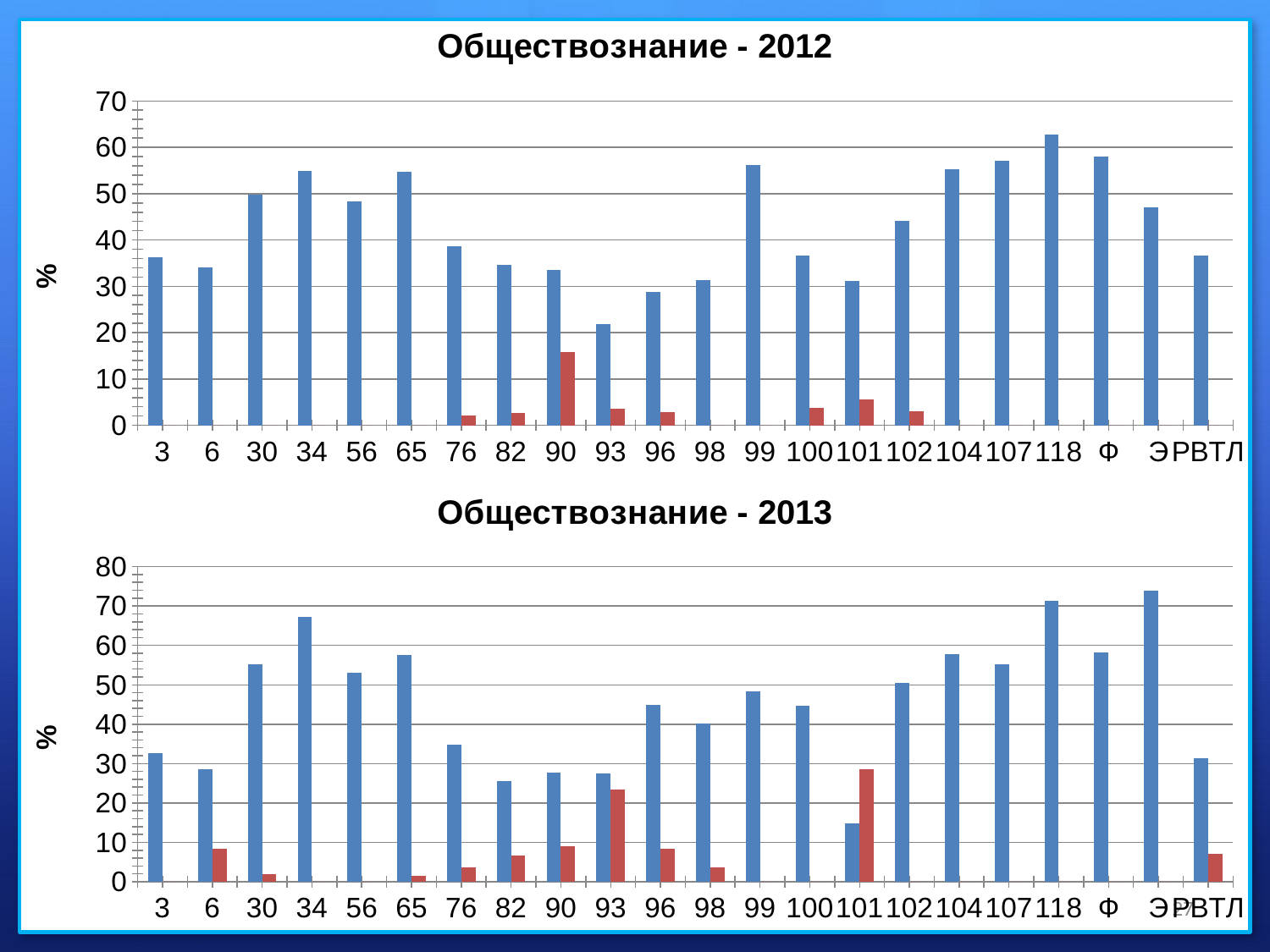
What type of chart is shown in the top chart titled "Обществознание - 2012"? bar chart In the "Обществознание - 2012" chart, which blue bar is taller: category 34 or category 3? 34 In the "Обществознание - 2012" chart, which category has the shortest blue bar? 93 In the "Обществознание - 2013" chart, which category has the shortest blue bar? 101 What is the title of the bottom chart on the slide? Обществознание - 2013 In the "Обществознание - 2013" chart, is the blue bar for category 101 greater or less than 20? less In the "Обществознание - 2012" chart, is the blue bar for category 118 greater or less than 60? greater In the "Обществознание - 2012" chart, is the blue bar for category 93 greater or less than 30? less In the "Обществознание - 2012" chart, which category has the tallest blue bar? 118 How many categories are shown on the x axis of the "Обществознание - 2013" chart? 22 In the "Обществознание - 2013" chart, which category has the tallest red bar? 101